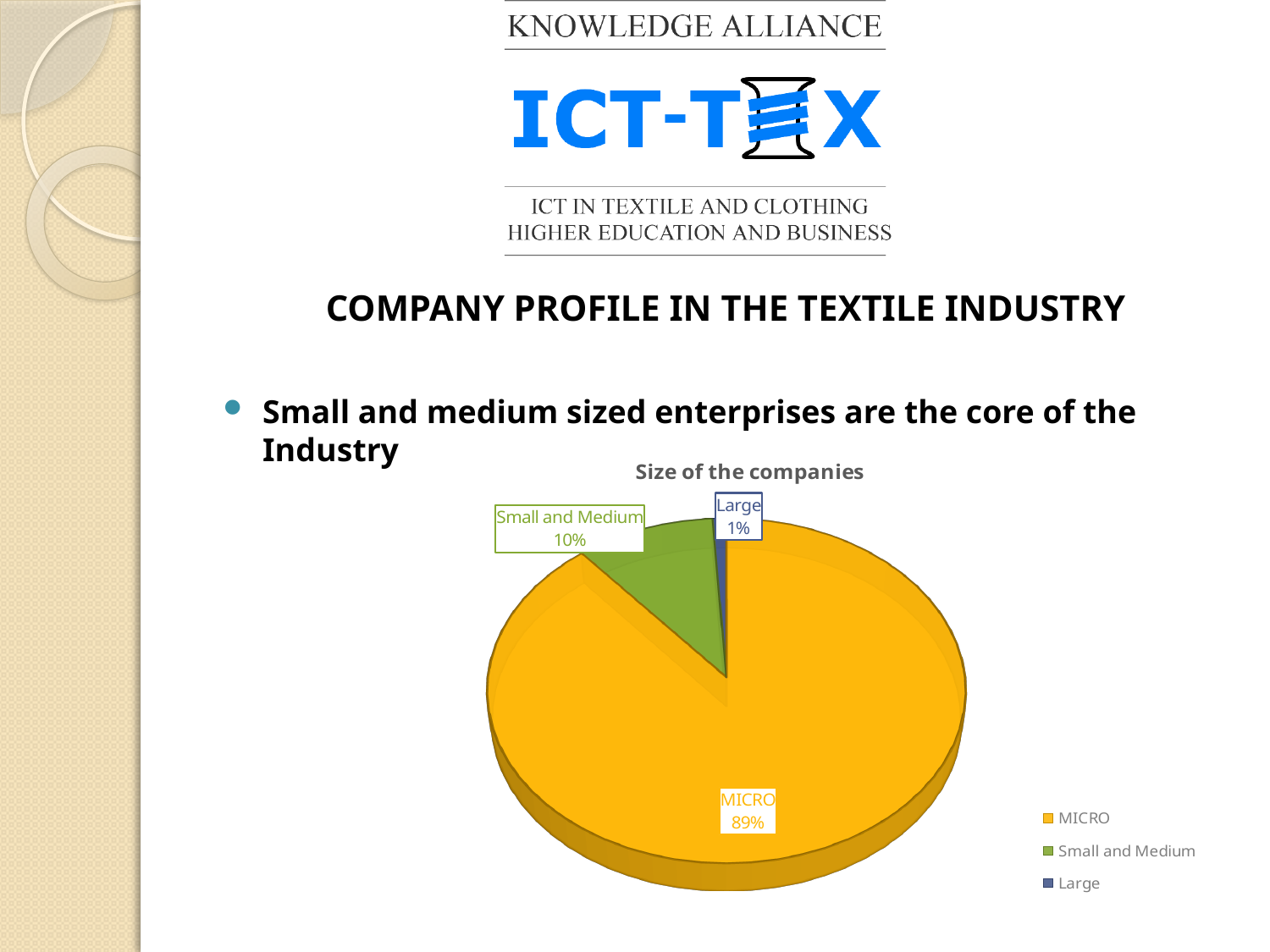
Which is larger, the share for Small and Medium or the share for Large? Small and Medium Which category has the smallest slice of the pie? Large What kind of chart is shown on the slide? pie chart What is the difference in percentage points between MICRO and Small and Medium? 79 What share of the pie does Large have? 1% How many entries does the legend list? 3 What share of the pie does MICRO have? 89% What is the title of the chart? Size of the companies How many categories are shown in the pie chart? 3 Which category has the largest slice of the pie? MICRO What share of the pie does Small and Medium have? 10% What colour is the MICRO slice in the pie chart? yellow